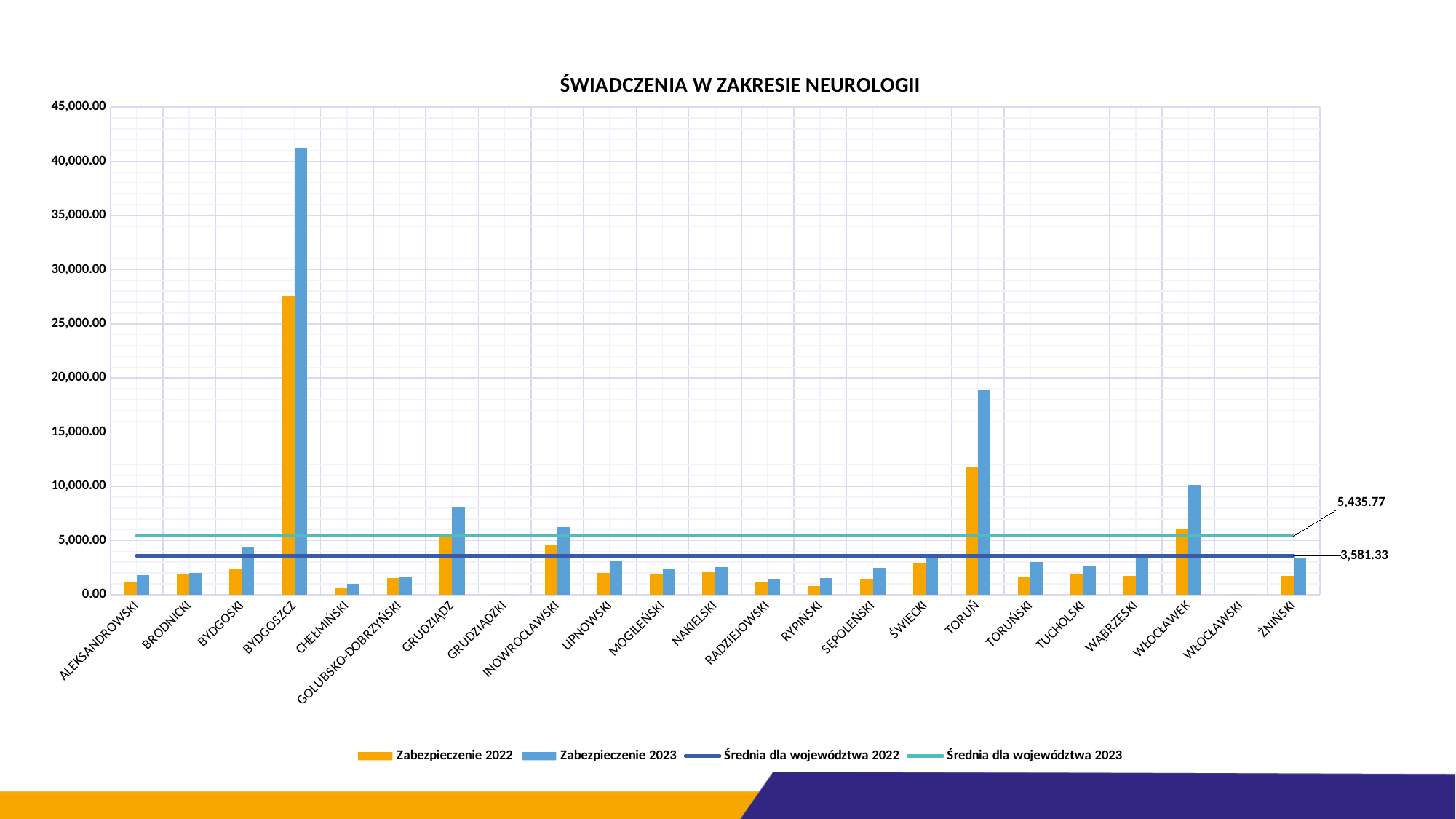
Is the Zabezpieczenie 2022 value for TORUŃ greater or less than 10,000.00? greater Which colour represents the Zabezpieczenie 2022 series? orange What is the difference between the Średnia dla województwa 2023 and Średnia dla województwa 2022 values? 1,854.44 What is the title of the chart? ŚWIADCZENIA W ZAKRESIE NEUROLOGII Which category has the highest Zabezpieczenie 2023 value? BYDGOSZCZ Is the Zabezpieczenie 2023 value for BYDGOSZCZ greater or less than 40,000.00? greater How many categories are shown on the x axis? 23 What is the value of the Średnia dla województwa 2022 line? 3,581.33 How many series does the legend list? 4 What is the value of the Średnia dla województwa 2023 line? 5,435.77 Which is larger, the Zabezpieczenie 2023 value for TORUŃ or for WŁOCŁAWEK? TORUŃ What kind of chart is shown on the slide? combination bar and line chart